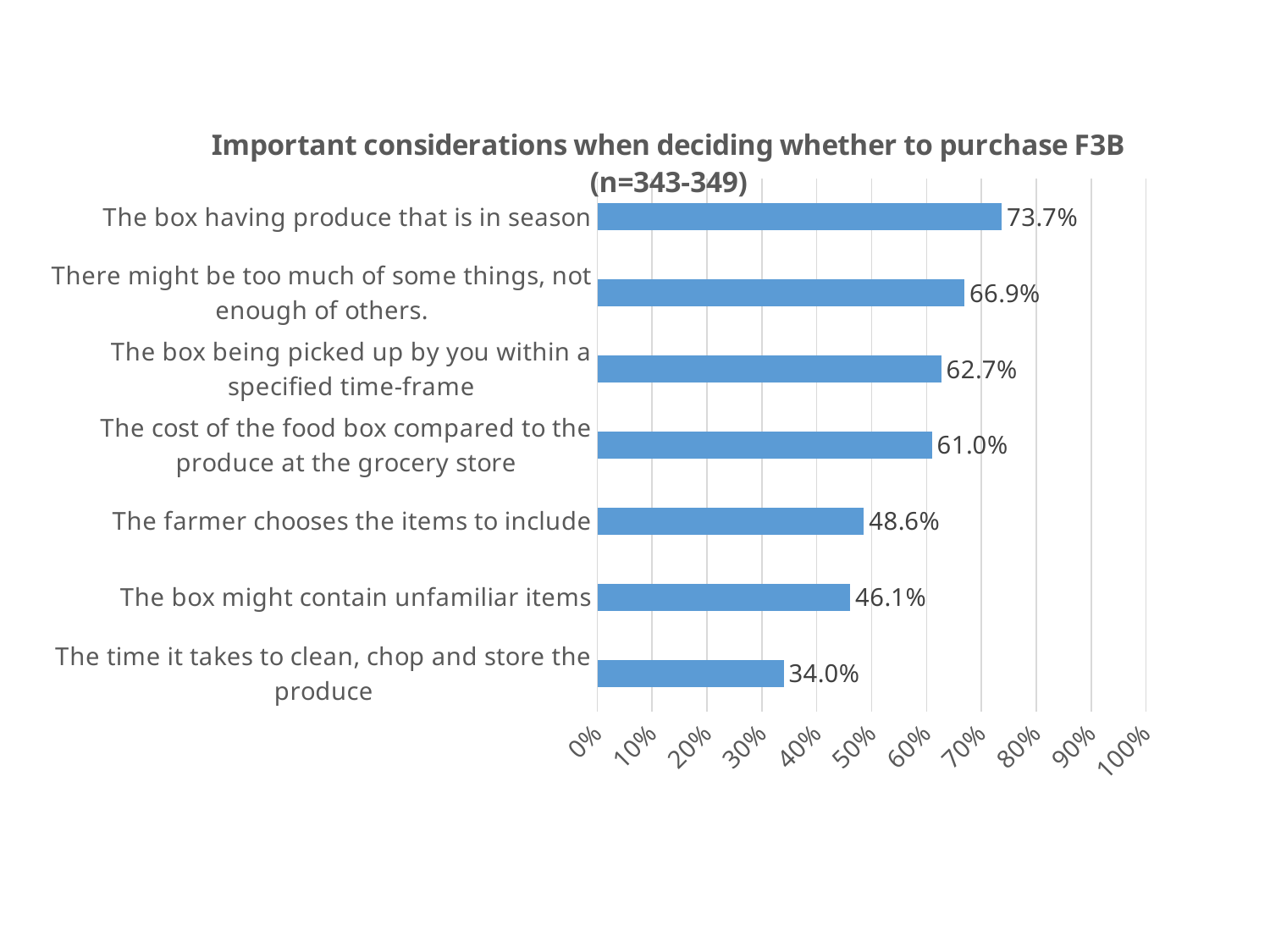
What is the difference between 'The box being picked up by you within a specified time-frame' and 'The cost of the food box compared to the produce at the grocery store'? 1.7% What kind of chart is shown on the slide? bar chart What is the value for 'The time it takes to clean, chop and store the produce'? 34.0% Is the value for 'The box might contain unfamiliar items' greater or less than 50%? less What is the value for 'The farmer chooses the items to include'? 48.6% Which consideration has the highest percentage? The box having produce that is in season What is the difference between 'The box having produce that is in season' and 'The box might contain unfamiliar items'? 27.6% What percentage of respondents considered the box having produce that is in season important? 73.7% Which consideration has the lowest percentage? The time it takes to clean, chop and store the produce What is the title of the chart? Important considerations when deciding whether to purchase F3B (n=343-349) How many considerations are shown in the chart? 7 Which is larger: the value for 'There might be too much of some things, not enough of others.' or the value for 'The farmer chooses the items to include'? There might be too much of some things, not enough of others.